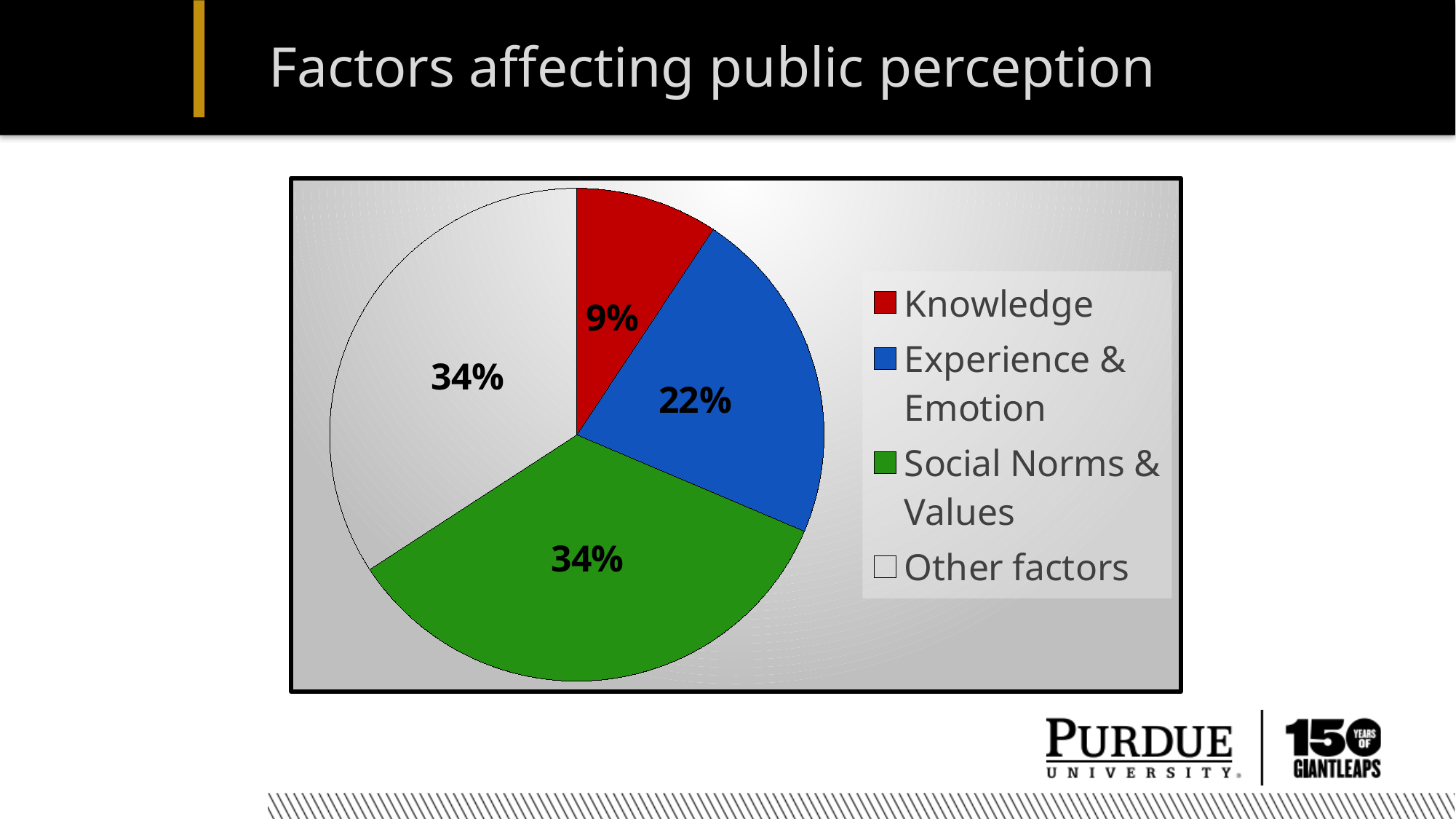
What percentage does the Other factors slice represent? 34% What is the title of the slide containing the chart? Factors affecting public perception What percentage does the Knowledge slice represent? 9% What colour is the Social Norms & Values slice? Green What kind of chart is shown on the slide? Pie chart What is the difference between the Experience & Emotion share and the Knowledge share? 13% What percentage does the Experience & Emotion slice represent? 22% What percentage does the Social Norms & Values slice represent? 34% How many entries does the legend list? 4 How many slices does the pie chart have? 4 Which is larger, the Experience & Emotion slice or the Knowledge slice? Experience & Emotion Which factor has the smallest share of the pie? Knowledge